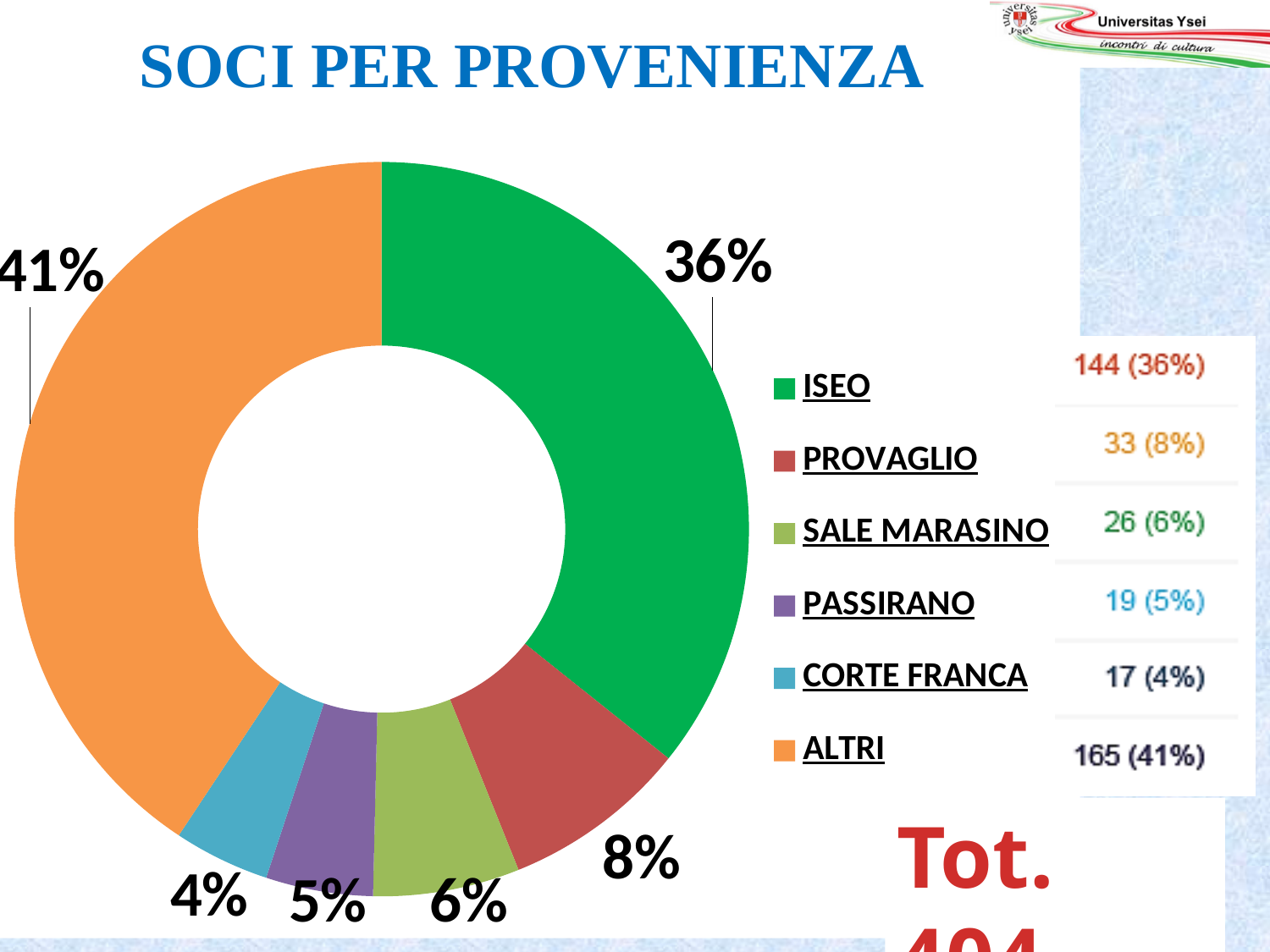
What percentage is shown for PROVAGLIO? 8% What share of the doughnut chart does ISEO represent? 36% What is the difference in percentage points between ALTRI and ISEO? 5 Which is larger, the slice for SALE MARASINO or the slice for CORTE FRANCA? SALE MARASINO Which category has the largest slice in the chart? ALTRI What colour is the ISEO slice in the chart? Green Which category has the smallest slice in the chart? CORTE FRANCA How many categories does the chart show? 6 What is the title of the chart? SOCI PER PROVENIENZA What kind of chart is shown on the slide? Doughnut chart What percentage is shown for PASSIRANO? 5% What percentage is shown for ALTRI in the chart? 41%